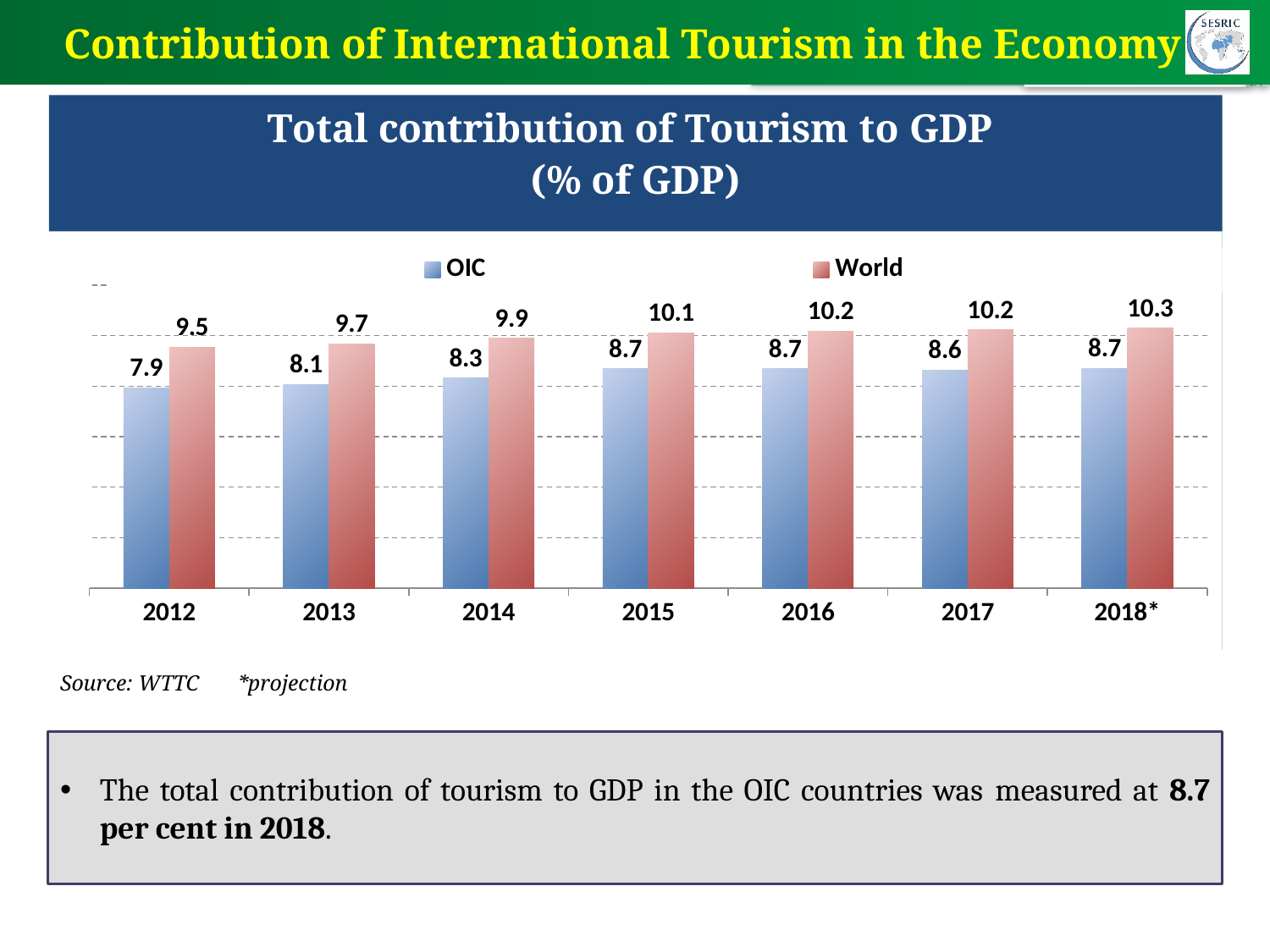
What is the title of the chart? Total contribution of Tourism to GDP (% of GDP) How many series does the legend list? 2 In which year is the World series highest? 2018* What is the difference between the World and OIC values in 2014? 1.6 What is the OIC value for 2012? 7.9 Does the World series rise or fall from 2012 to 2018*? Rise What is the World value for 2018*? 10.3 Which is larger in 2015, the OIC value or the World value? World How many years are shown on the x axis? 7 In which year is the OIC series lowest? 2012 What is the OIC value for 2017? 8.6 What kind of chart is shown? Bar chart